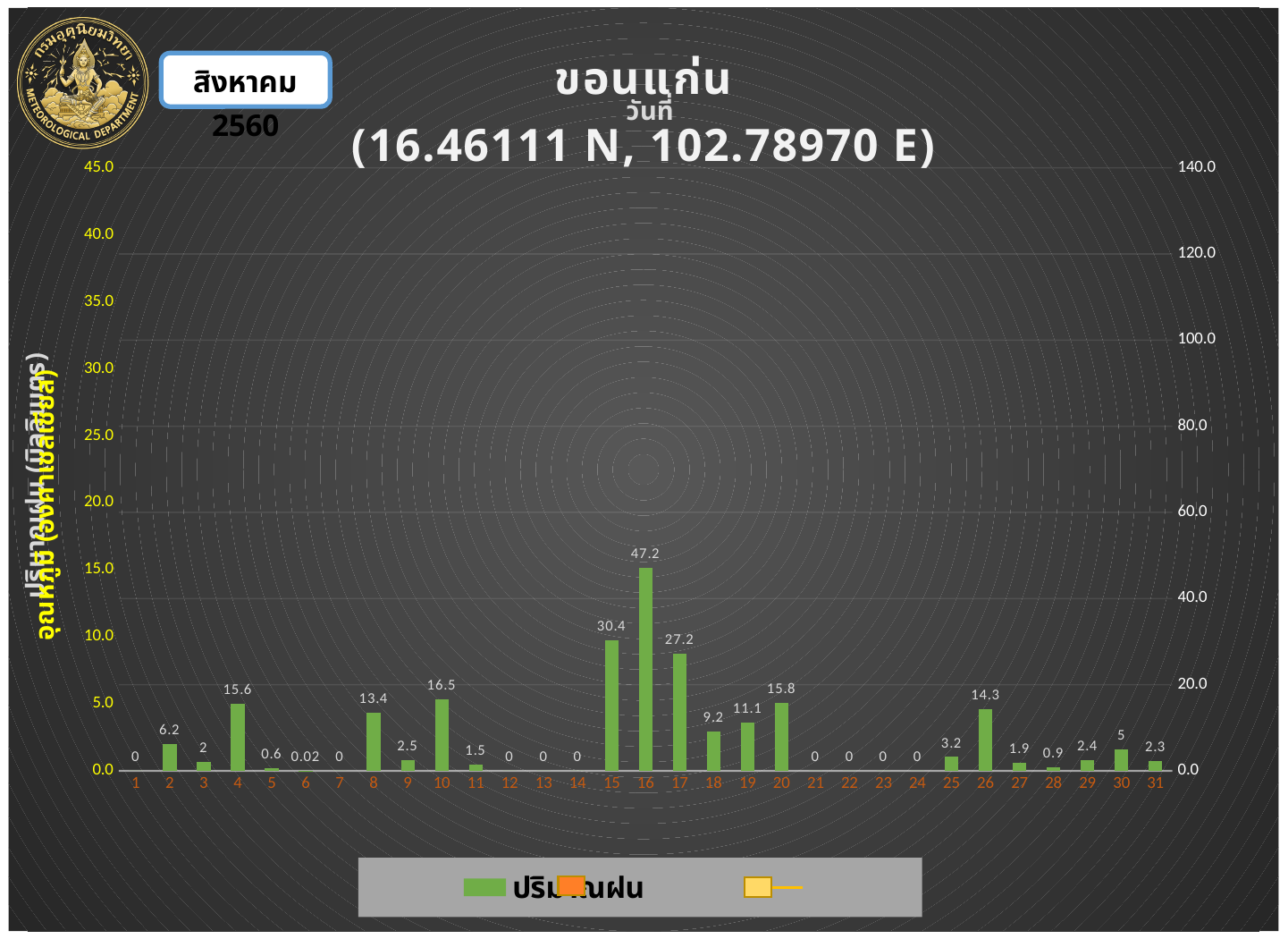
What is the difference between the rainfall values for day 17 and day 18? 18 What is the difference between the rainfall values for day 16 and day 15? 16.8 Which has a larger rainfall value, day 4 or day 10? day 10 What type of chart is shown on the slide? bar chart What is the rainfall value for day 4? 15.6 What is the rainfall value for day 16? 47.2 Which day has the highest rainfall value? 16 What location name appears in the chart title? ขอนแก่น What is the rainfall value for day 26? 14.3 Which has a larger rainfall value, day 19 or day 20? day 20 How many days are shown on the x axis? 31 What is the rainfall value for day 6? 0.02